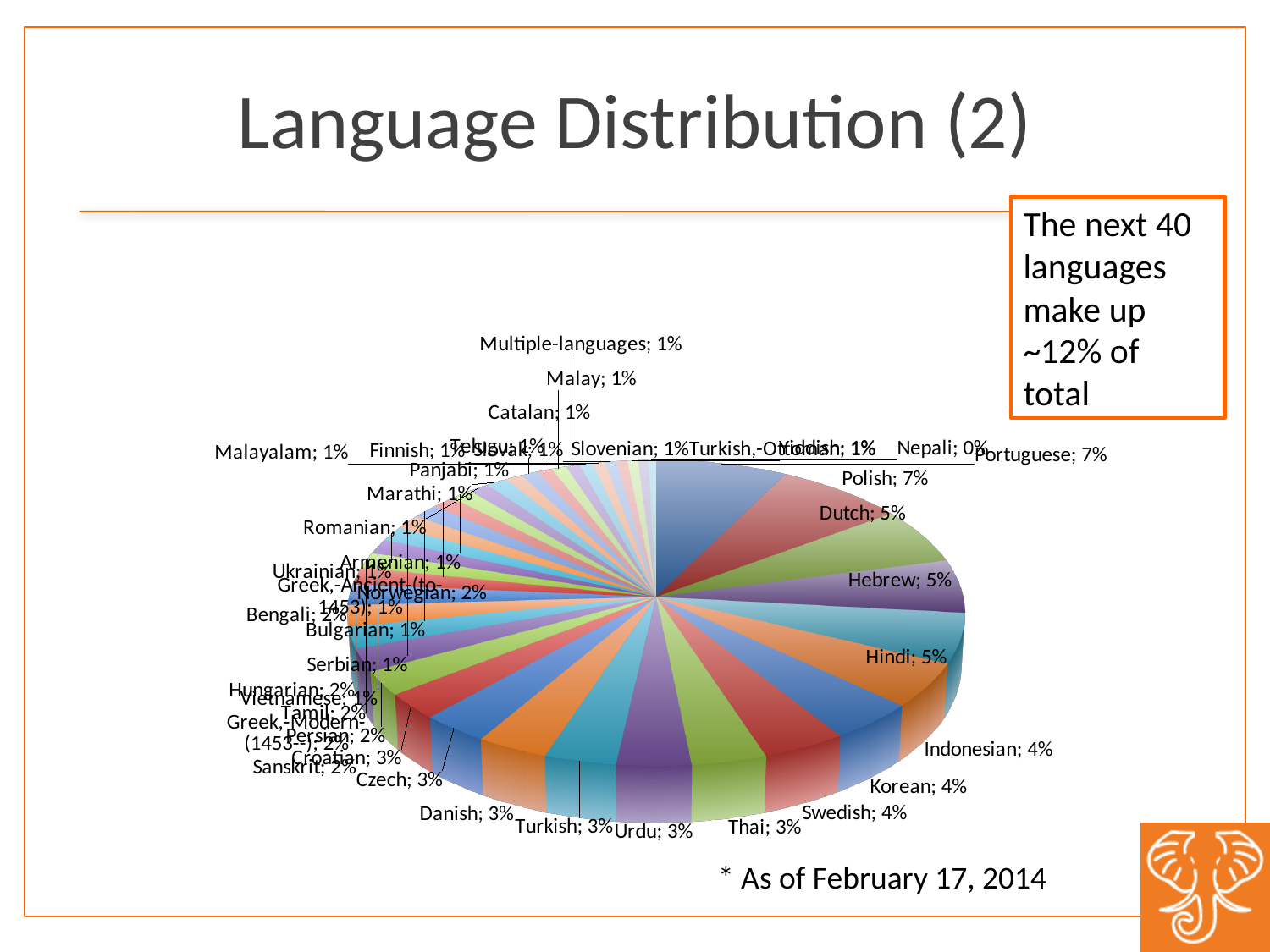
What is the difference in percentage points between Hebrew and Korean? 1% What kind of chart is shown on the slide? pie chart What is the title of the slide containing the chart? Language Distribution (2) What percentage is shown for Indonesian? 4% Which has a larger share, Polish or Hindi? Polish What percentage is shown for Czech? 3% What percentage is shown for Sanskrit? 2% What percentage is shown for Malayalam? 1% Which language has the smallest share shown on the chart? Nepali What percentage is shown for Dutch? 5% What share of the total does Portuguese have? 7% According to the text box, what share of the total do the next 40 languages make up? ~12%